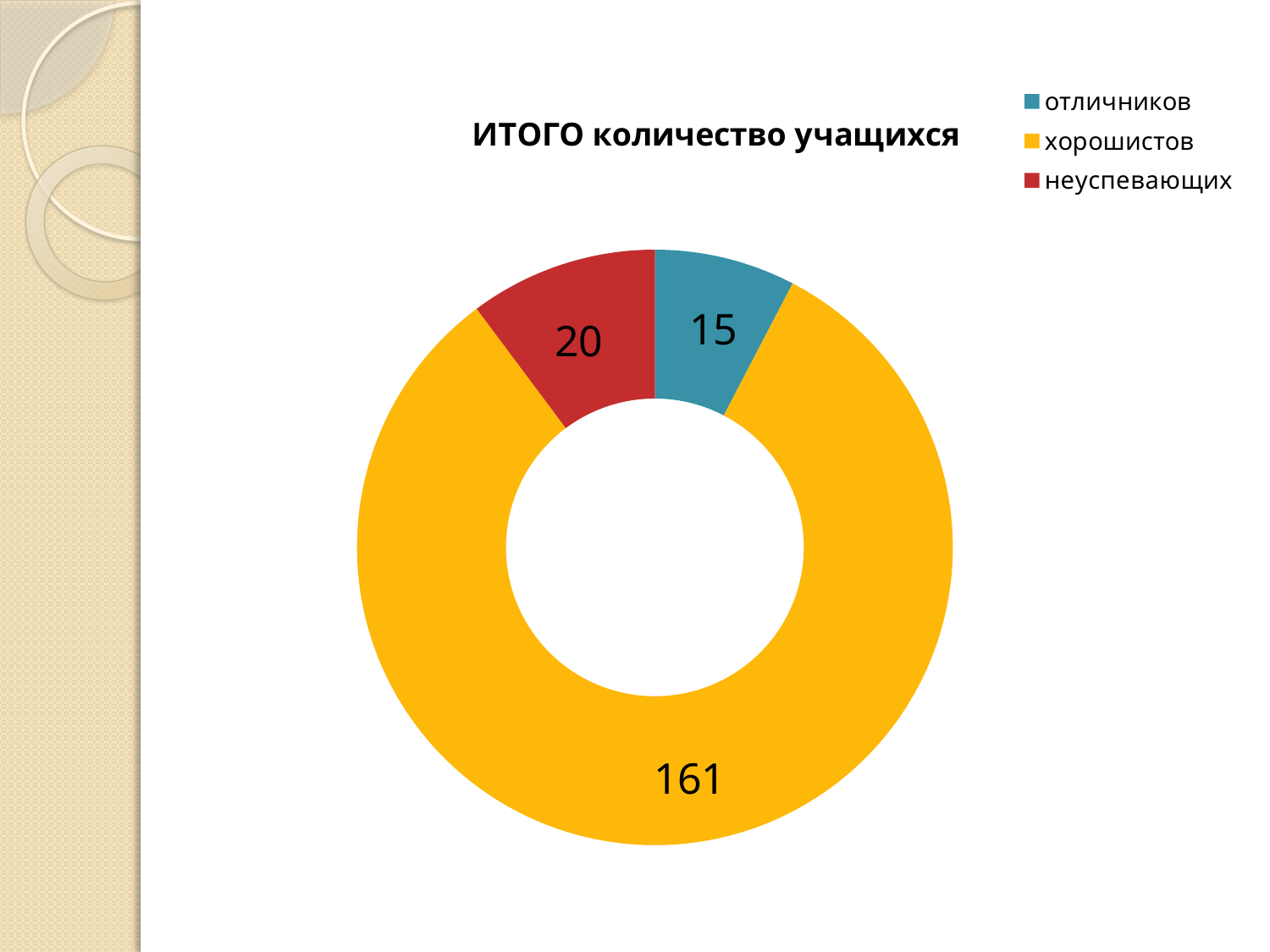
What is the difference between the values for хорошистов and неуспевающих? 141 What is the total of all values shown in the chart? 196 What is the value for хорошистов? 161 Which category has the lowest value? отличников How many categories are shown in the chart? 3 What kind of chart is shown on the slide? doughnut chart Which category has the highest value? хорошистов What is the difference between the values for неуспевающих and отличников? 5 What is the title of the chart? ИТОГО количество учащихся Which is larger, the value for неуспевающих or the value for отличников? неуспевающих What is the value for отличников? 15 What is the value for неуспевающих? 20